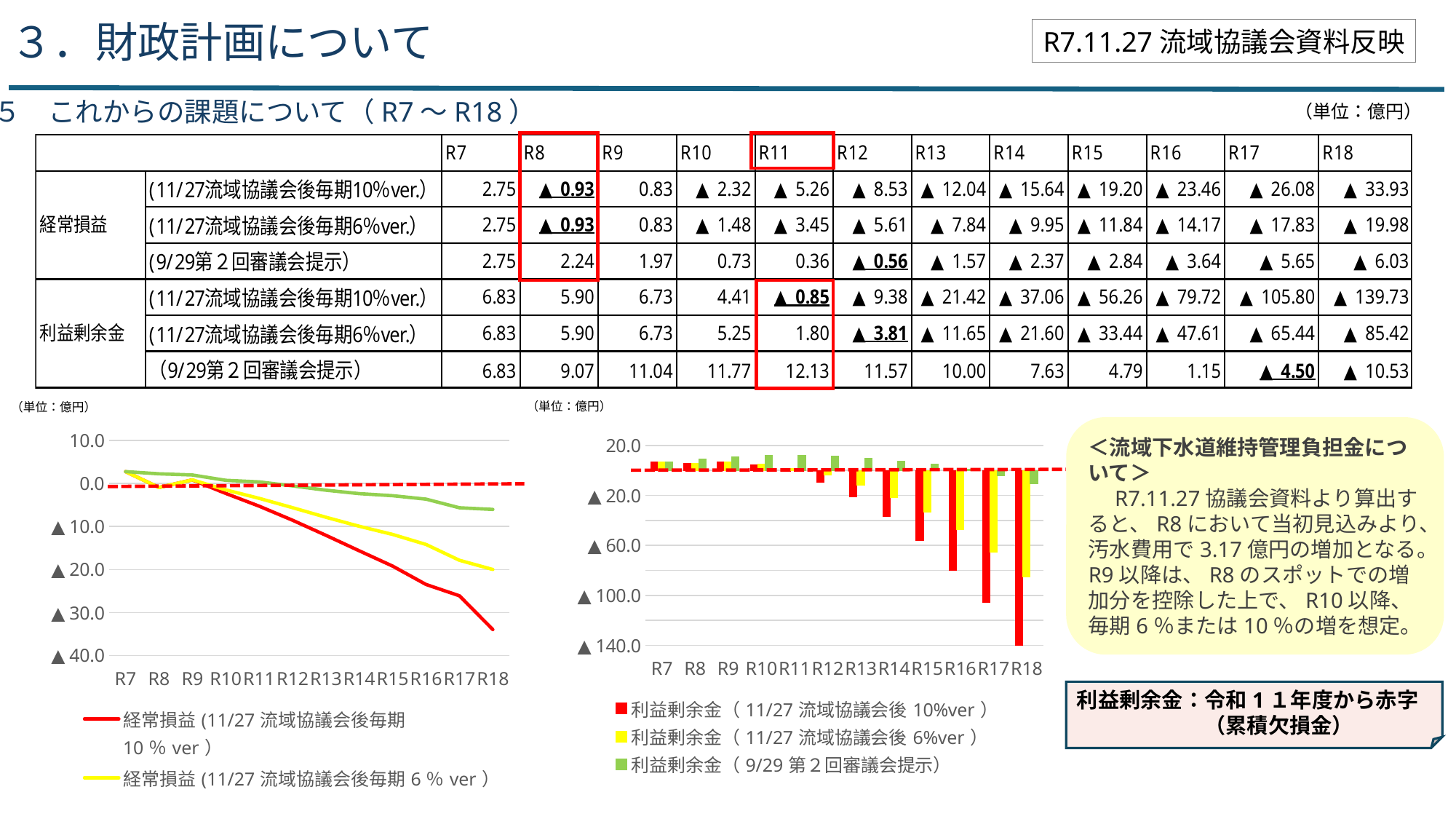
What kind of chart is the left chart (経常損益)? line chart In the right chart (利益剰余金), is the red bar (10% ver) at R17 greater or less than ▲100.0? less In the right chart (利益剰余金), which series has the lowest bar at R18? 利益剰余金（11/27 流域協議会後 10%ver） In the left chart (経常損益), does the red line (11/27 流域協議会後毎期10% ver) rise or fall from R7 to R18? fall In the left chart (経常損益), at which year is the red line (10% ver) at its lowest? R18 What is the 利益剰余金 value for the 11/27 流域協議会後毎期10% ver. series at R11, as printed in the table? ▲ 0.85 In the left chart (経常損益), is the value of the red line (10% ver) at R18 greater or less than ▲30.0? less What kind of chart is the right chart (利益剰余金)? bar chart How many series does the legend of the left chart (経常損益) list? 2 How many categories are shown on the x axis of the right chart (利益剰余金)? 12 How many series does the legend of the right chart (利益剰余金) list? 3 In the right chart (利益剰余金), is the green bar (9/29 第2回審議会提示) at R11 greater or less than 20.0? less